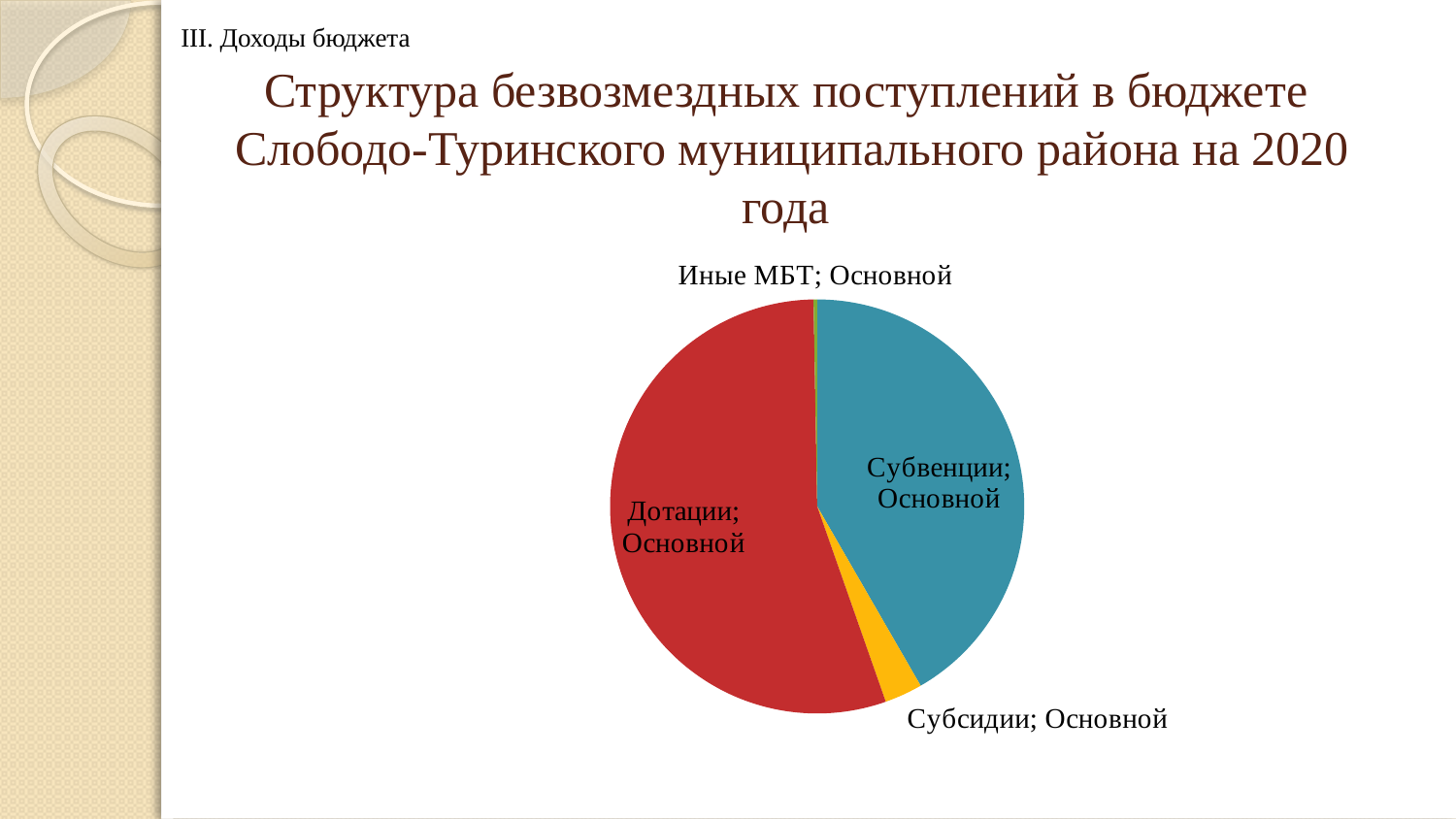
Which category has the smallest slice of the pie? Иные МБТ What colour is the Субсидии slice? Yellow What colour is the Дотации slice? Red Which category has the largest slice of the pie? Дотации Which category is the second-largest slice of the pie? Субвенции How many slices does the pie chart have? 4 Which slice is larger, Субсидии or Субвенции? Субвенции Which slice is larger, Субсидии or Иные МБТ? Субсидии What kind of chart is shown on the slide? Pie chart